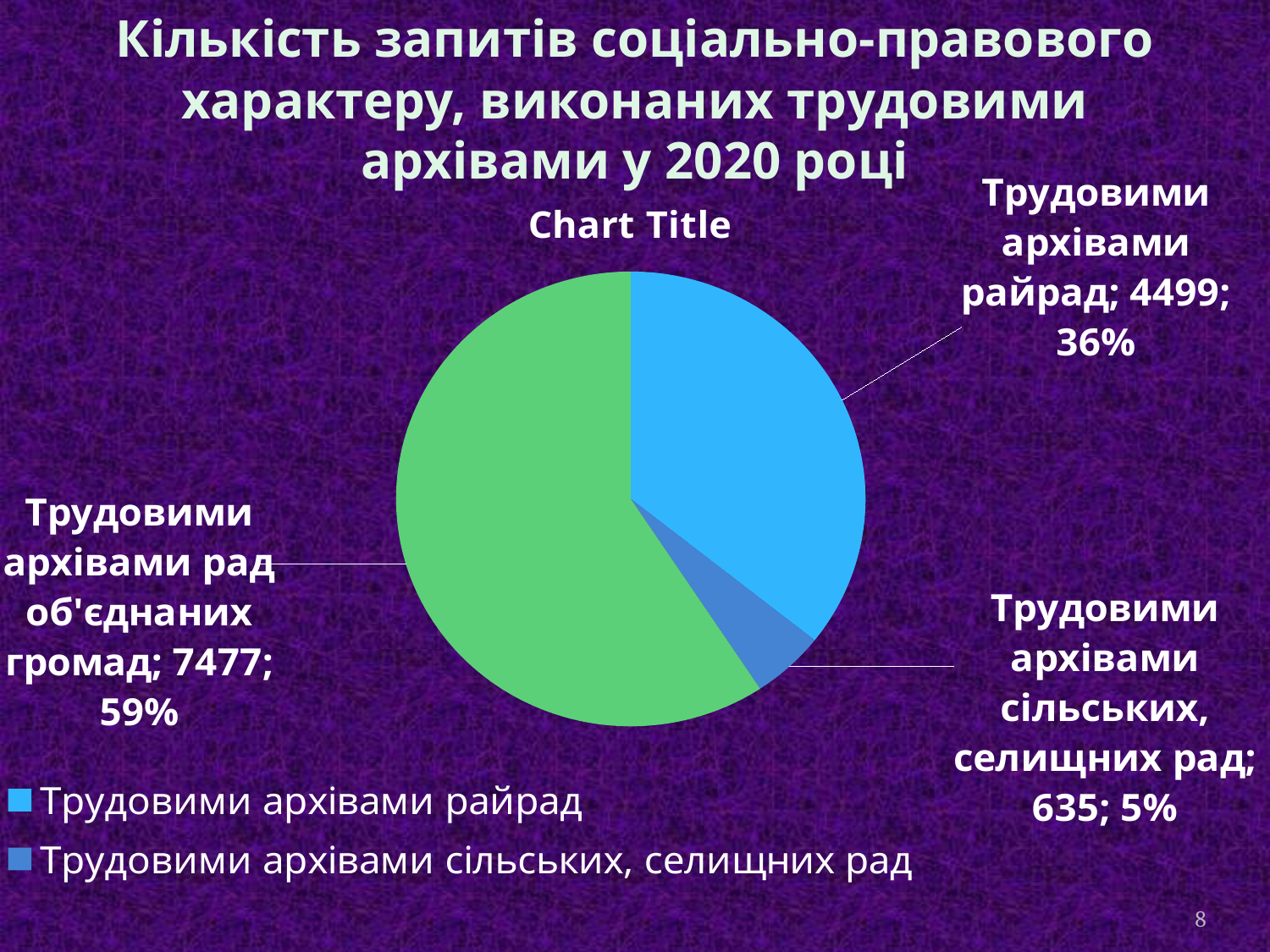
Which category has the smallest slice? Трудовими архівами сільських, селищних рад Which is larger: the value for Трудовими архівами райрад or for Трудовими архівами сільських, селищних рад? Трудовими архівами райрад How many slices does the pie chart have? 3 What share of the pie does Трудовими архівами рад об'єднаних громад take? 59% What is the title printed directly above the pie chart? Chart Title What is the value for Трудовими архівами райрад? 4499 What share of the pie does Трудовими архівами райрад take? 36% What kind of chart is shown on the slide? pie chart What is the difference between the values for Трудовими архівами рад об'єднаних громад and Трудовими архівами райрад? 2978 Which category has the largest slice? Трудовими архівами рад об'єднаних громад What is the value for Трудовими архівами рад об'єднаних громад? 7477 What is the value for Трудовими архівами сільських, селищних рад? 635